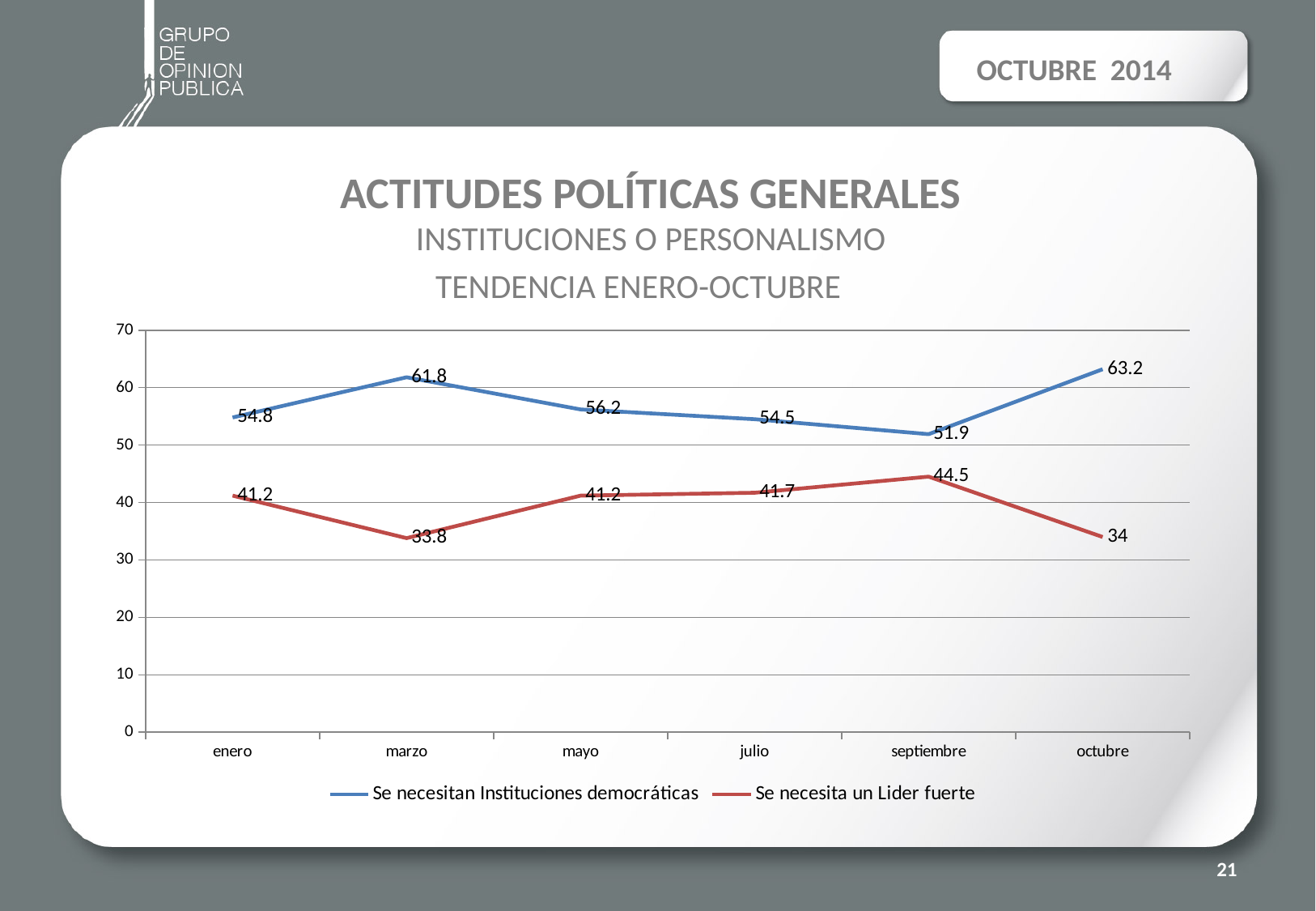
Which series has the larger value in enero? Se necesitan Instituciones democráticas What is the value for 'Se necesitan Instituciones democráticas' in octubre? 63.2 What is the value for 'Se necesita un Lider fuerte' in septiembre? 44.5 What kind of chart is shown? line chart What is the difference between the two series in octubre? 29.2 What is the value for 'Se necesita un Lider fuerte' in marzo? 33.8 In which month is 'Se necesita un Lider fuerte' lowest? marzo In which month is 'Se necesitan Instituciones democráticas' highest? octubre How many months are shown on the x axis? 6 Does 'Se necesita un Lider fuerte' rise or fall from septiembre to octubre? fall How many series does the legend list? 2 What colour is the line for 'Se necesita un Lider fuerte'? red